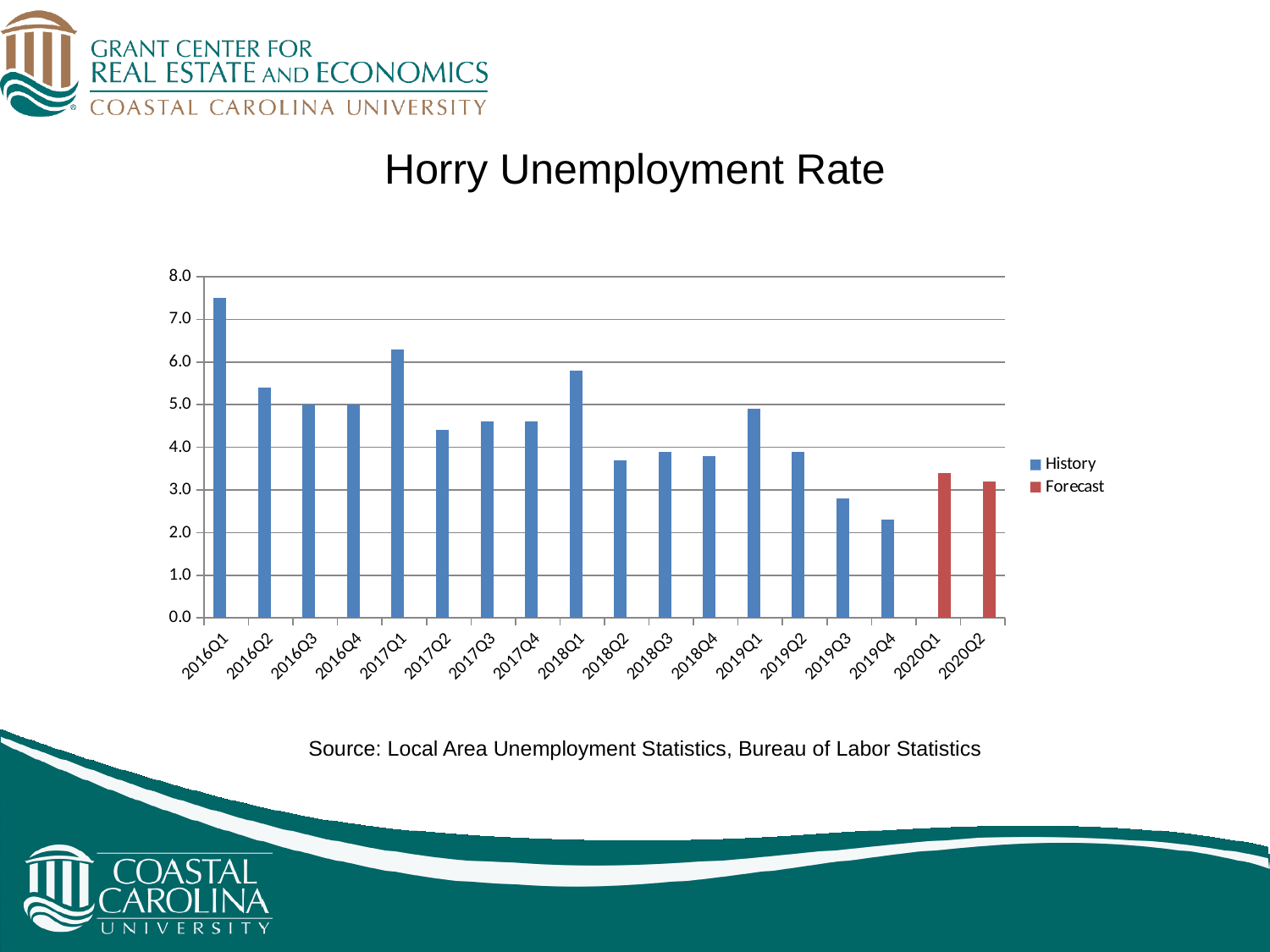
Which quarter has the lowest unemployment rate? 2019Q4 Is the value for 2019Q4 greater or less than 3.0? less Which series is shown in red? Forecast Is the value for 2017Q1 greater or less than 6.0? greater How many series does the legend list? 2 Is the value for 2016Q1 greater or less than 7.0? greater What is the title of the chart? Horry Unemployment Rate What kind of chart is shown on the slide? bar chart How many quarters are shown on the x axis? 18 Which is larger, the value for 2018Q1 or the value for 2019Q1? 2018Q1 Which quarter has the highest unemployment rate? 2016Q1